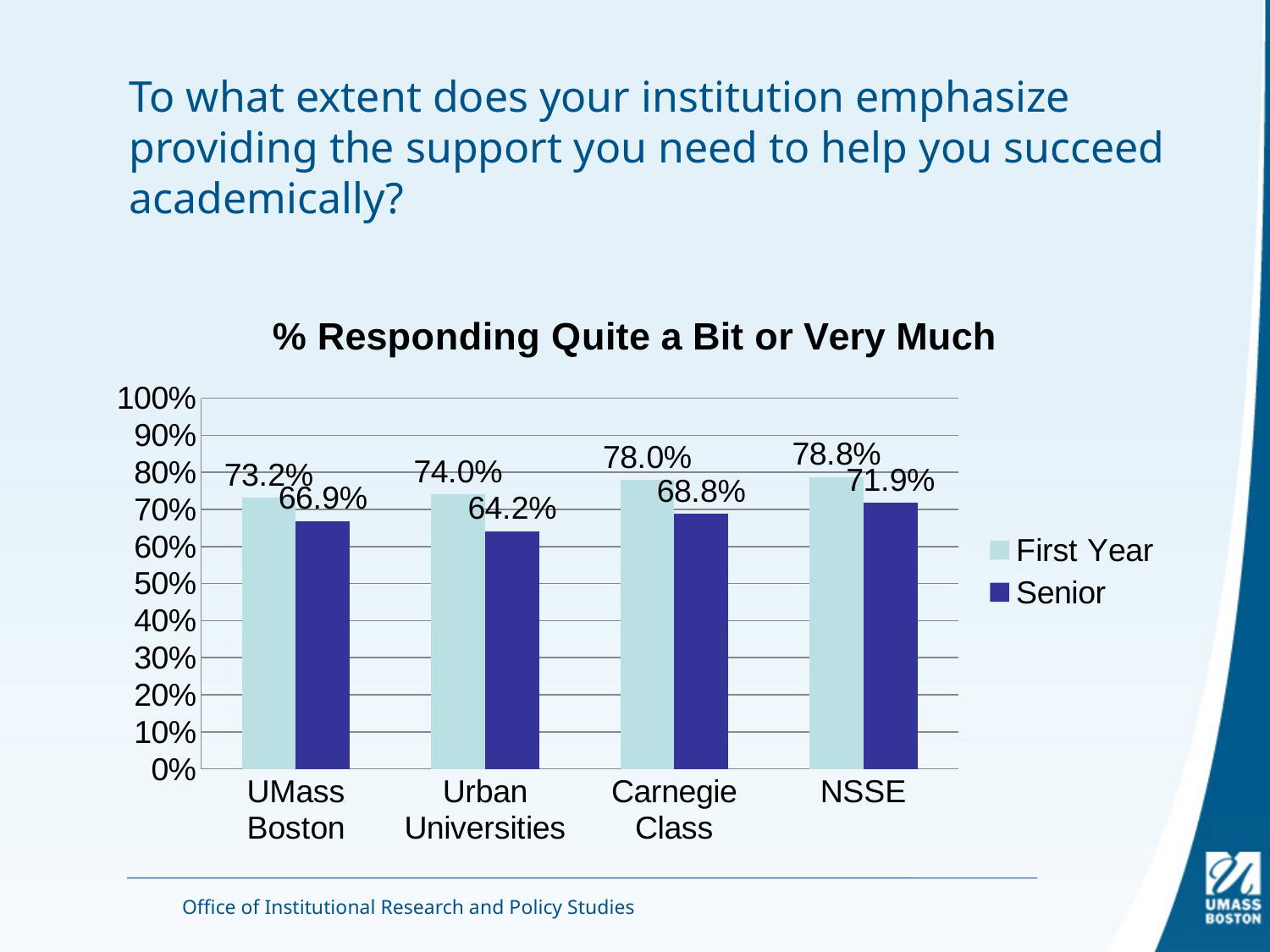
What is the title of the chart? % Responding Quite a Bit or Very Much What is the Senior value for Urban Universities? 64.2% Which category has the lowest Senior value? Urban Universities Which is larger, the Senior value for UMass Boston or the Senior value for Carnegie Class? Carnegie Class What is the difference between the First Year and Senior values for Carnegie Class? 9.2% What kind of chart is shown? bar chart How many categories are shown on the x axis? 4 What is the First Year value for UMass Boston? 73.2% Which category has the highest First Year value? NSSE Is the First Year value for Urban Universities greater or less than 70%? greater How many series does the legend list? 2 What is the Senior value for NSSE? 71.9%